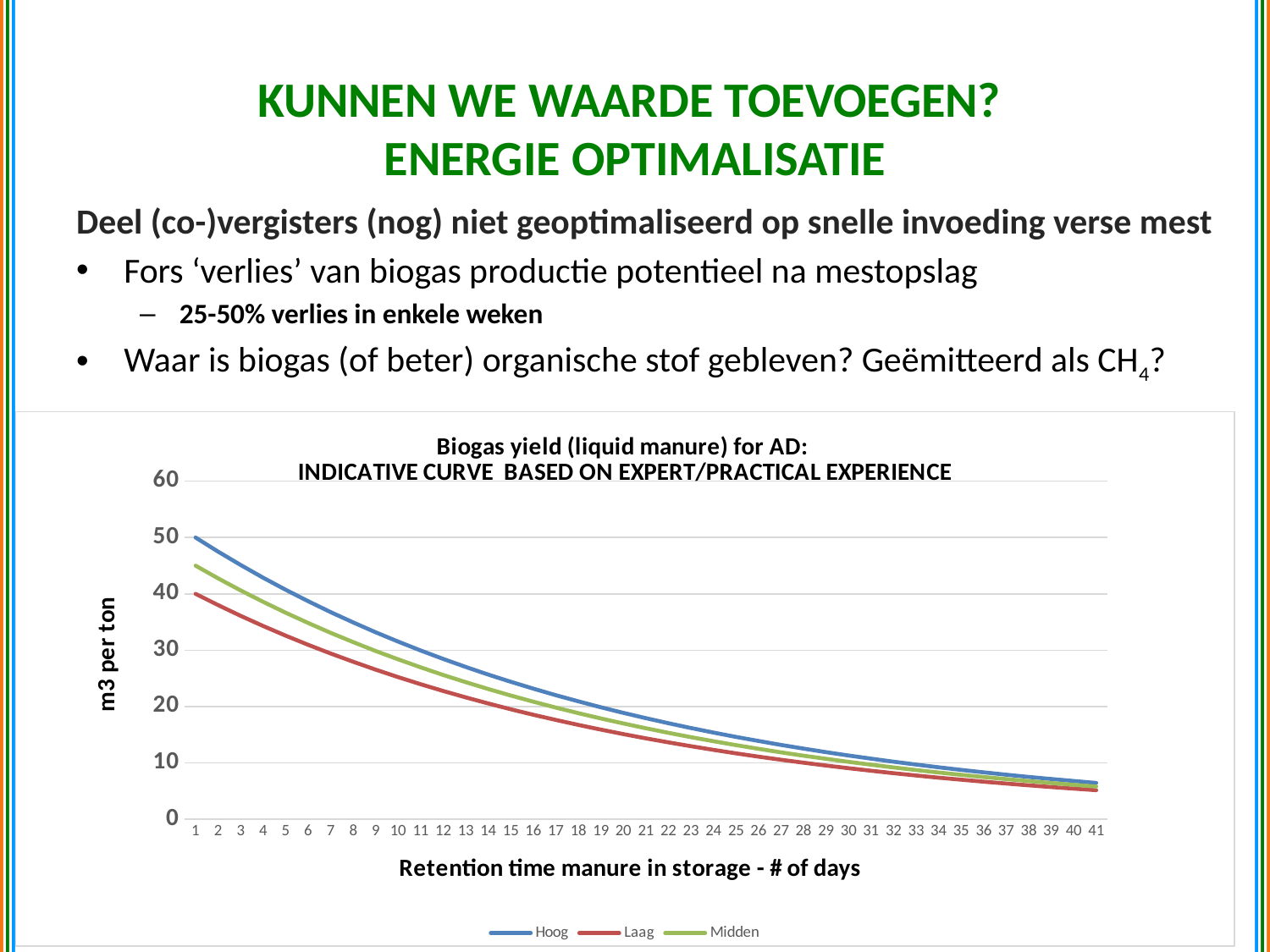
How many series does the legend list? 3 Is the value for Laag at day 20 greater or less than 20? less Is the value for Hoog at day 10 greater or less than 30? greater At day 10, which series has the larger value, Hoog or Laag? Hoog What is the value of the Hoog series at day 1? 50 Do the values rise or fall as the retention time increases along the x axis? fall Which series has the lowest value at day 1? Laag What kind of chart is shown on the slide? line chart Which series has the highest value at day 1? Hoog Is the value for Hoog at day 41 greater or less than 10? less What is the value of the Laag series at day 1? 40 What is the label of the y axis? m3 per ton